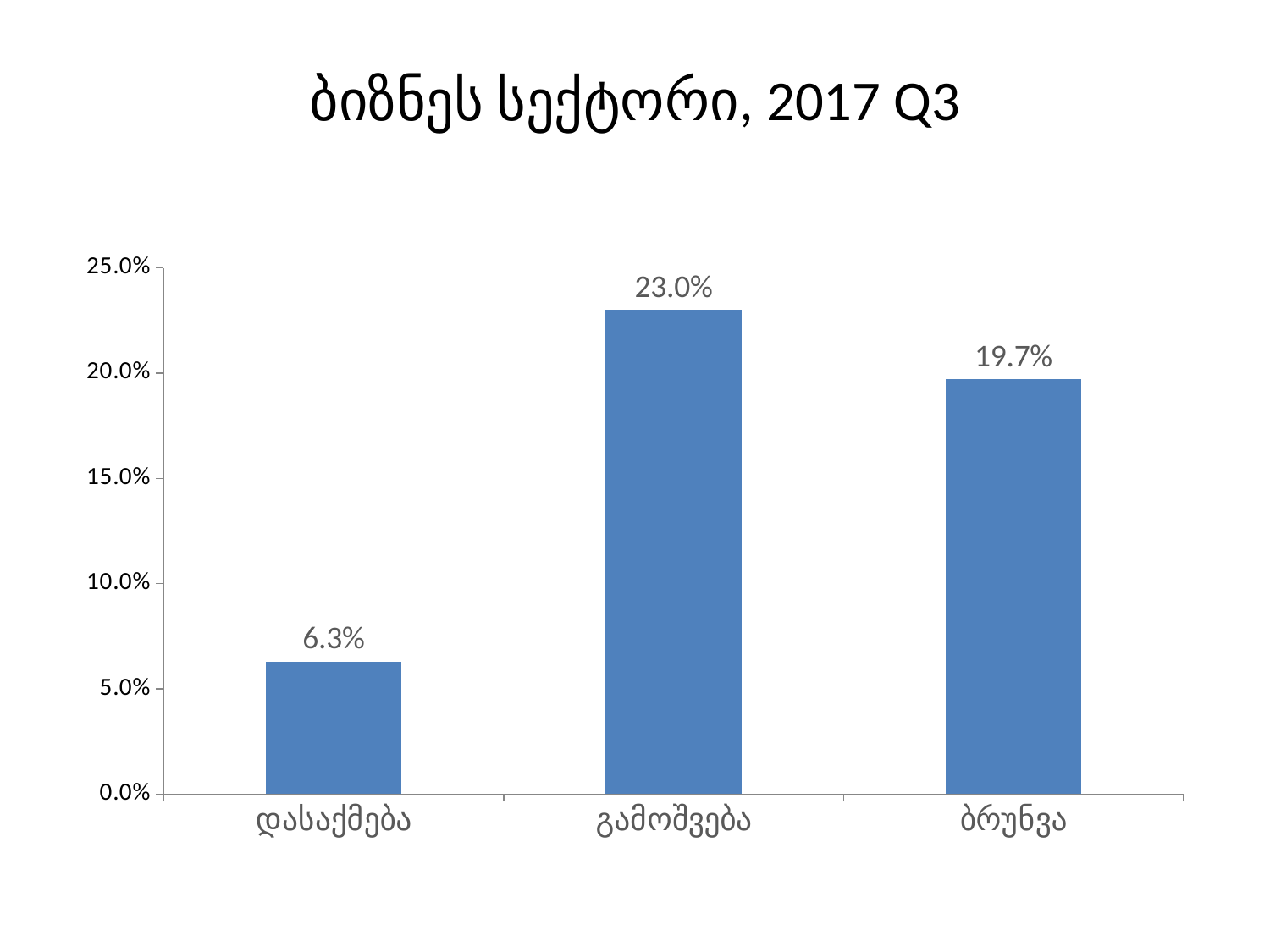
Which is larger, the value for დასაქმება or the value for ბრუნვა? ბრუნვა What kind of chart is shown on the slide? bar chart What is the title of the chart? ბიზნეს სექტორი, 2017 Q3 What is the value for დასაქმება? 6.3% Which category has the lowest value? დასაქმება Is the value for გამოშვება greater or less than 20.0%? greater What is the value for ბრუნვა? 19.7% What is the difference between the values for ბრუნვა and დასაქმება? 13.4% What is the value for გამოშვება? 23.0% How many categories are shown on the chart? 3 What is the difference between the values for გამოშვება and ბრუნვა? 3.3% Which category has the highest value? გამოშვება